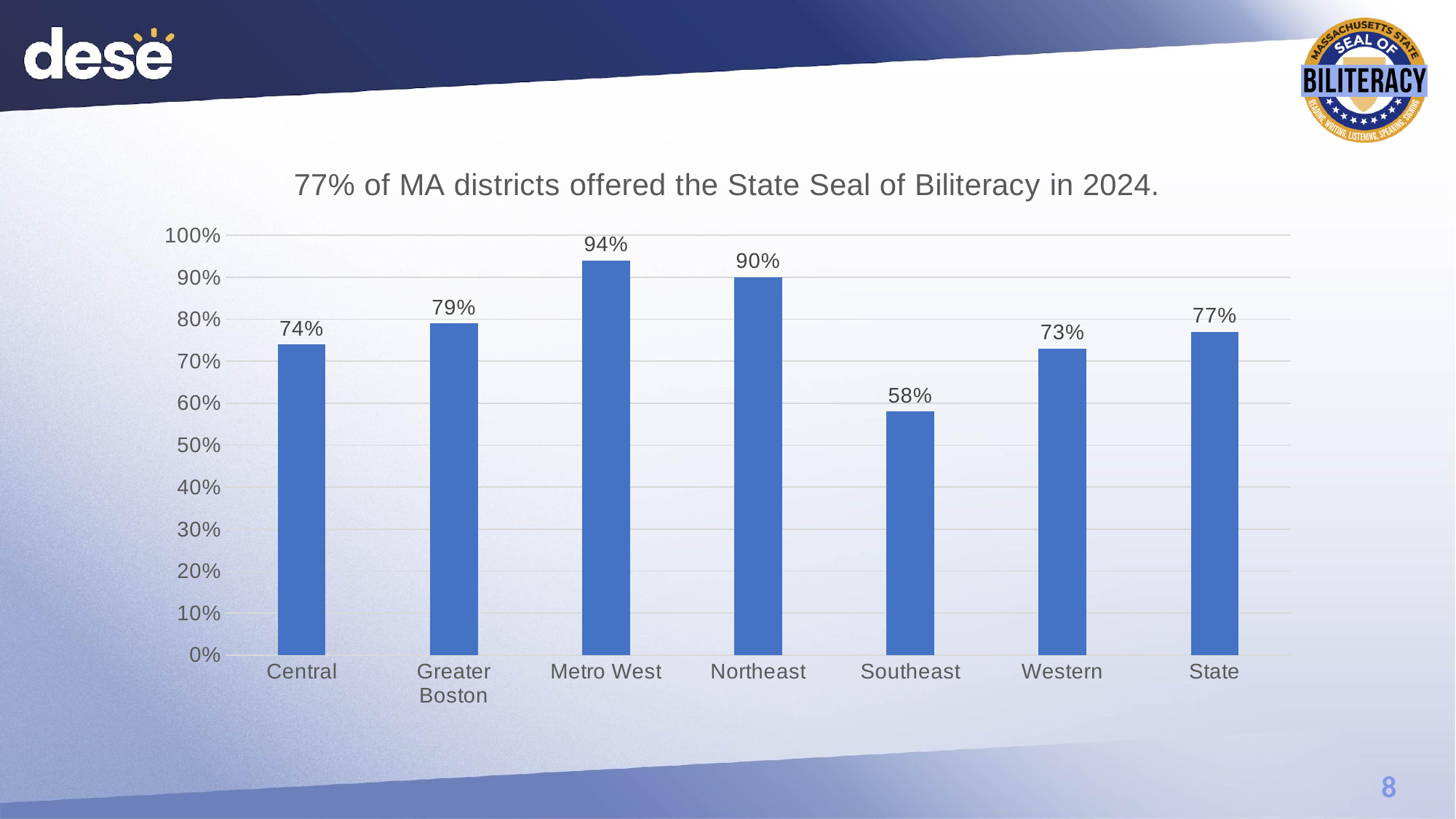
How many categories are shown on the x axis? 7 What is the value for Southeast? 58% What kind of chart is shown on the slide? Bar chart What is the difference between the values for Metro West and Southeast? 36% Which category has the lowest value? Southeast What is the value for State? 77% What is the difference between the values for Northeast and Western? 17% Which category has the highest value? Metro West What is the title of the chart? 77% of MA districts offered the State Seal of Biliteracy in 2024. Which is larger, the value for Central or the value for Greater Boston? Greater Boston What is the value for Greater Boston? 79% What is the value for Metro West? 94%